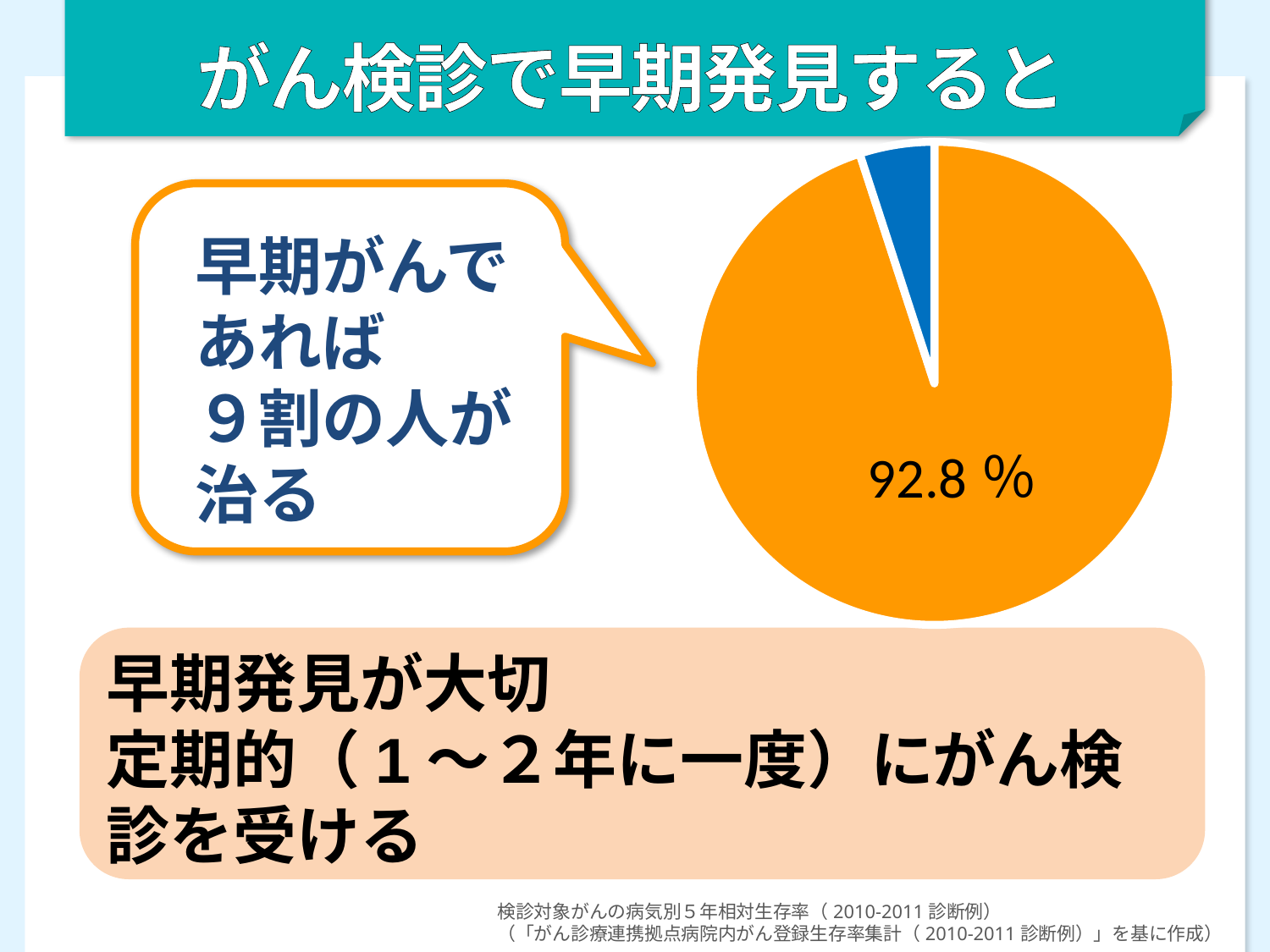
Which slice of the pie chart is larger, the orange one or the blue one? the orange one Which slice of the pie chart is the smallest? the blue slice Does the pie chart show a legend? no What colour is the largest slice of the pie chart? orange How many slices does the pie chart have? 2 What value is printed on the orange slice of the pie chart? 92.8 % What share of the pie does the orange slice represent? 92.8 % What kind of chart is shown on the slide? pie chart